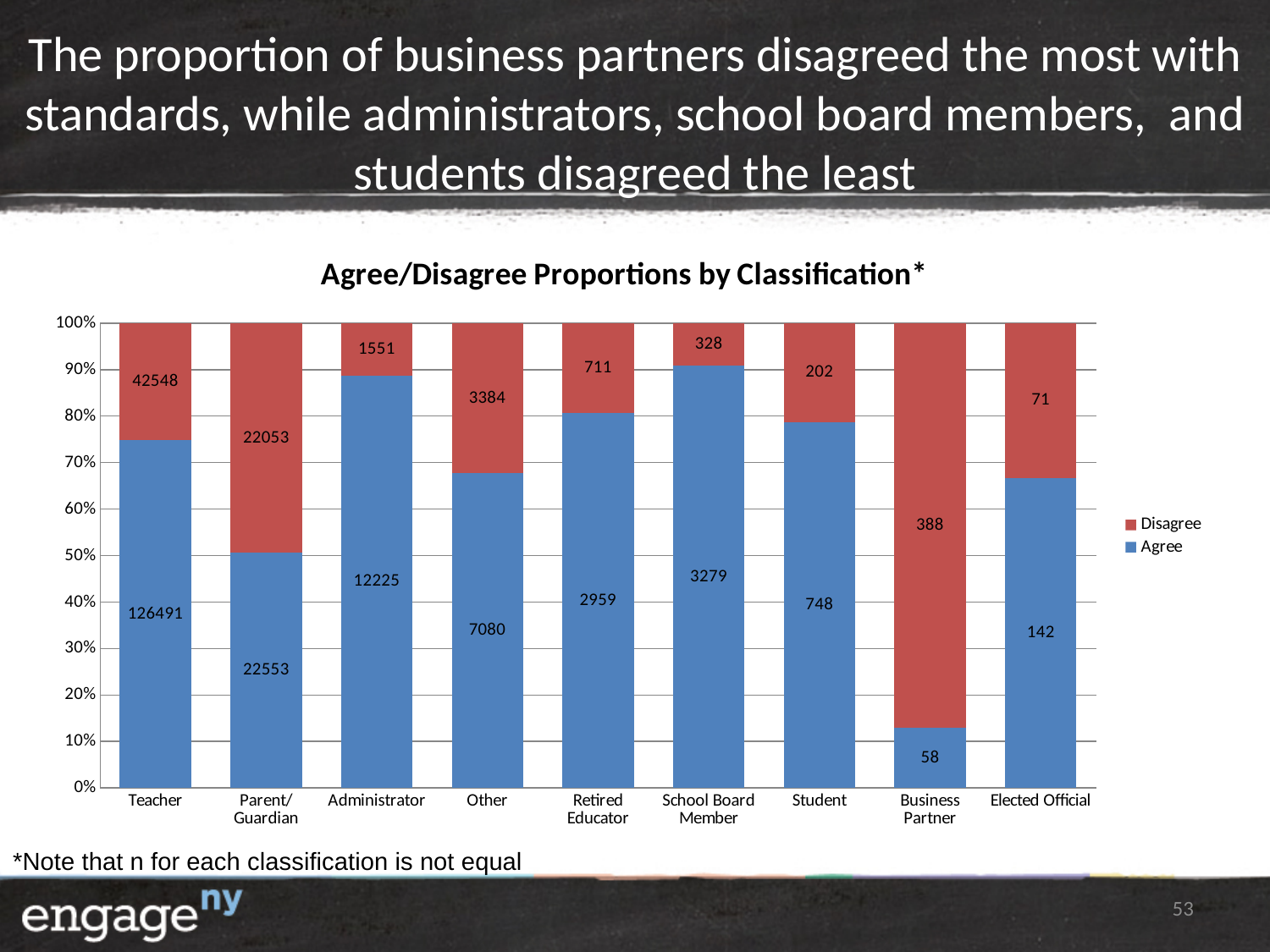
Is the Agree proportion for Business Partner greater or less than 20%? less What is the Disagree value for Business Partner? 388 Which classification has the lowest Agree count? Business Partner What is the total number of Agree and Disagree responses for Student? 950 What is the Agree value for School Board Member? 3279 Which classification has the highest Disagree count? Teacher What is the Agree value for Teacher? 126491 How many classifications are shown on the x axis? 9 How many series does the legend list? 2 What kind of chart is shown? Stacked bar chart Which is larger for Elected Official, the Agree count or the Disagree count? Agree What is the difference between the Agree and Disagree counts for Parent/Guardian? 500